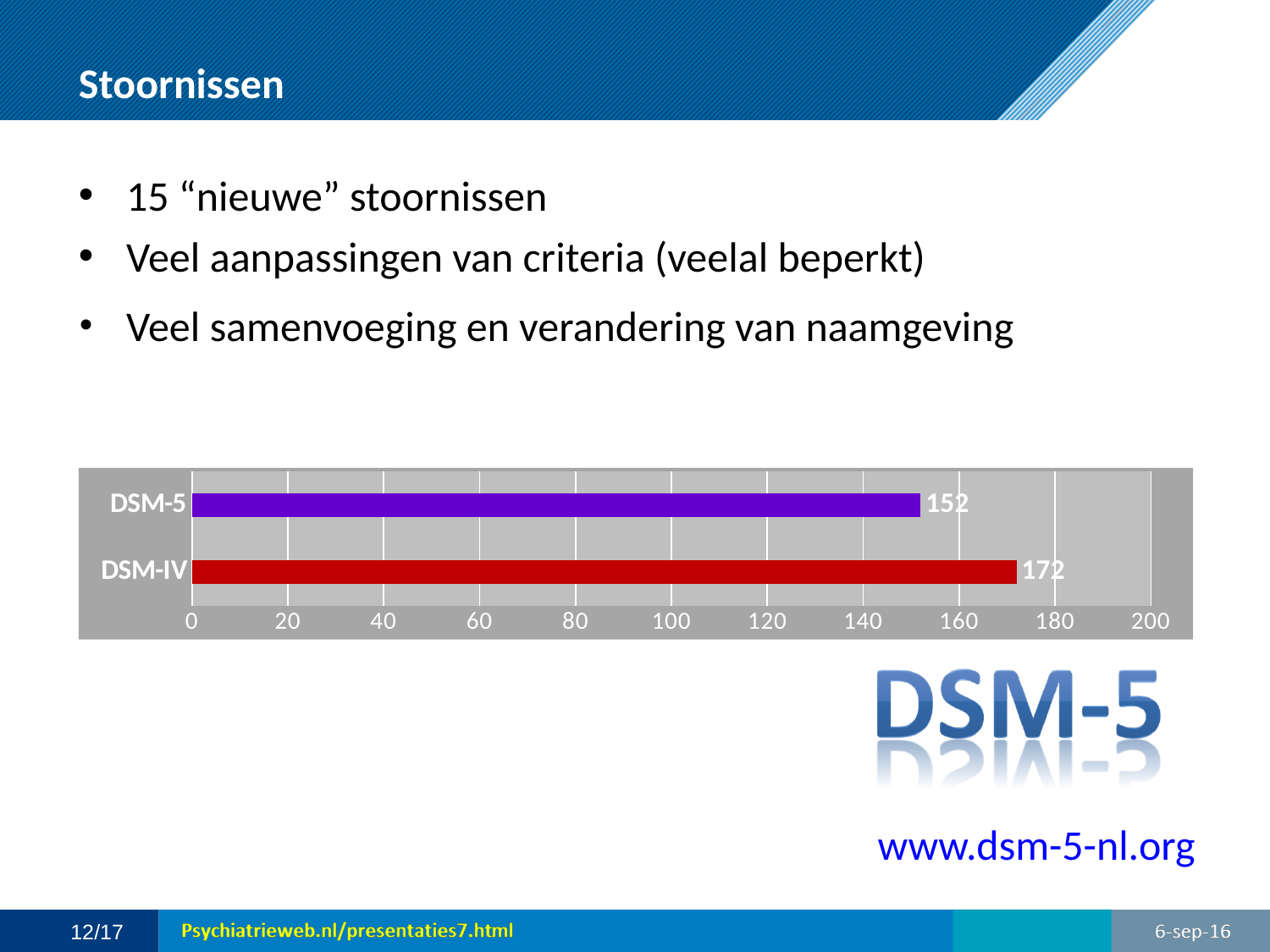
Is the value for DSM-5 greater or less than 160? less What colour is the bar for DSM-IV? red What is the value for DSM-IV in the bar chart? 172 Which category has the lowest value in the bar chart? DSM-5 How many categories are shown in the bar chart? 2 Which is larger, the value for DSM-5 or the value for DSM-IV? DSM-IV What is the value for DSM-5 in the bar chart? 152 Is the value for DSM-IV greater or less than 160? greater What is the difference between the values for DSM-IV and DSM-5? 20 What kind of chart is shown on the slide? bar chart Which category has the highest value in the bar chart? DSM-IV What is the maximum value shown on the x axis of the chart? 200